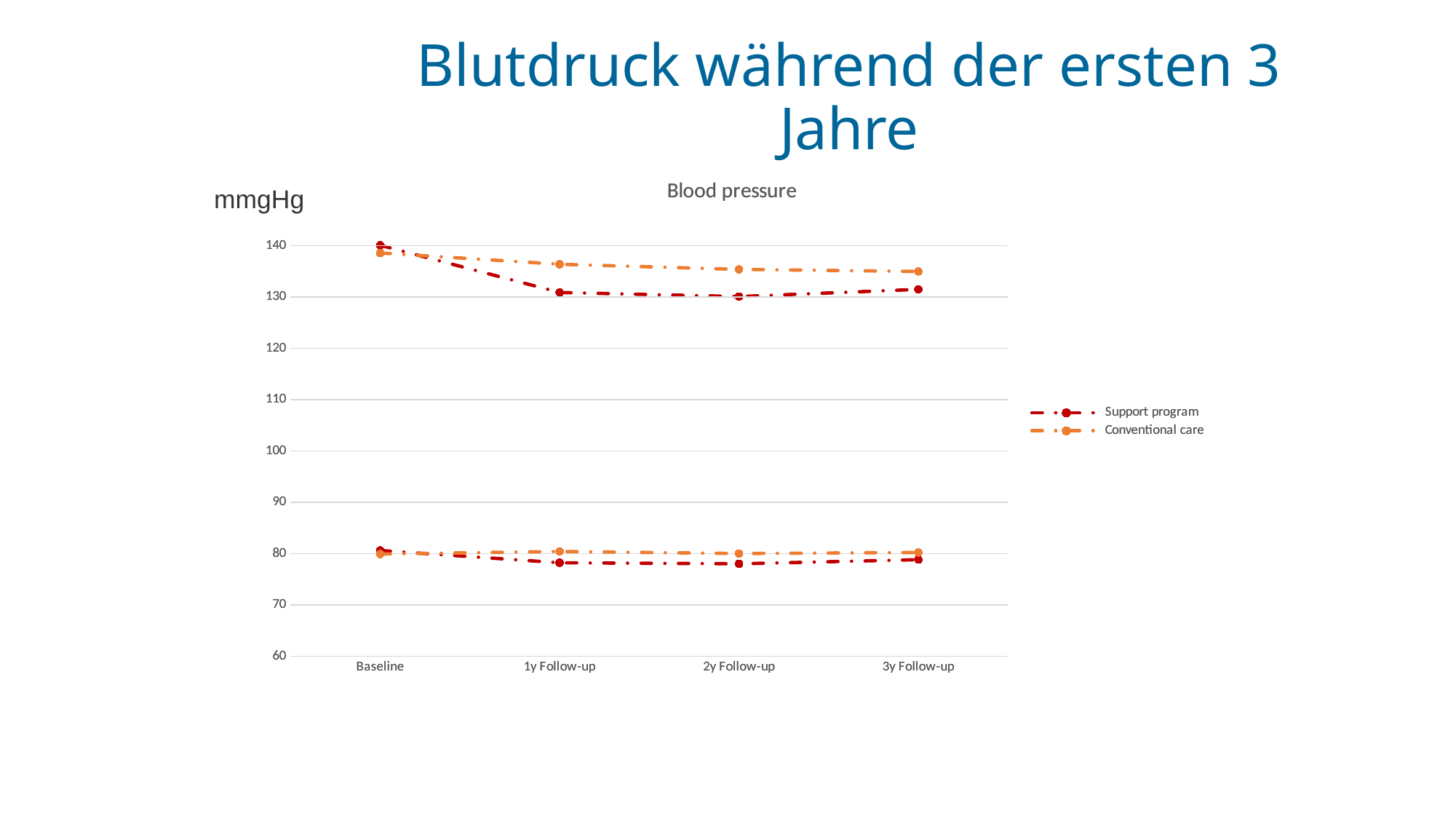
How many series does the legend list? 2 How many time points are shown on the x axis? 4 At 3y follow-up, which upper line is higher: Support program or Conventional care? Conventional care Does the upper Support program line rise or fall from Baseline to 1y Follow-up? fall Is the value of the lower Conventional care line at Baseline greater or less than 90? less Is the value of the upper Conventional care line at 3y follow-up greater or less than 130? greater What kind of chart is shown on the slide? line chart Does the upper Conventional care line rise or fall from Baseline to 3y follow-up? fall What unit label is shown above the y axis? mmgHg What is the title of the chart? Blood pressure Is the value of the upper Support program line at 1y Follow-up greater or less than 140? less